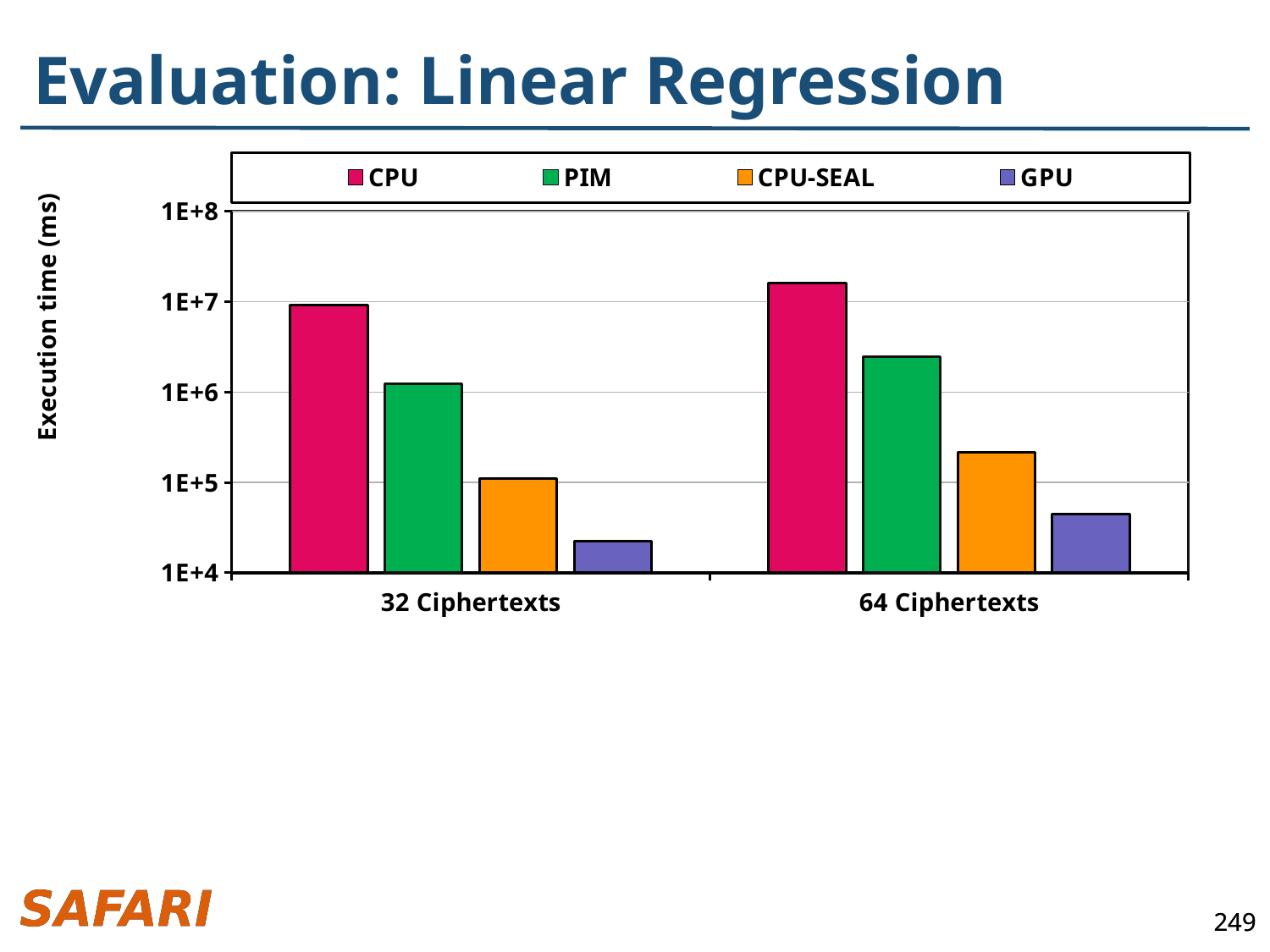
Is the value for GPU at 64 Ciphertexts greater or less than 1E+5? less Which series has the lowest execution time for 64 Ciphertexts? GPU Which series has the highest execution time for 32 Ciphertexts? CPU Is the value for CPU at 64 Ciphertexts greater or less than 1E+7? greater Which is larger, the CPU value for 32 Ciphertexts or the CPU value for 64 Ciphertexts? 64 Ciphertexts How many categories are shown on the x axis? 2 Does the execution time for PIM rise or fall from 32 Ciphertexts to 64 Ciphertexts? rise What kind of chart is shown on the slide? bar chart How many series does the legend list? 4 Is the value for GPU at 32 Ciphertexts greater or less than 1E+4? greater What is the label of the y axis? Execution time (ms)